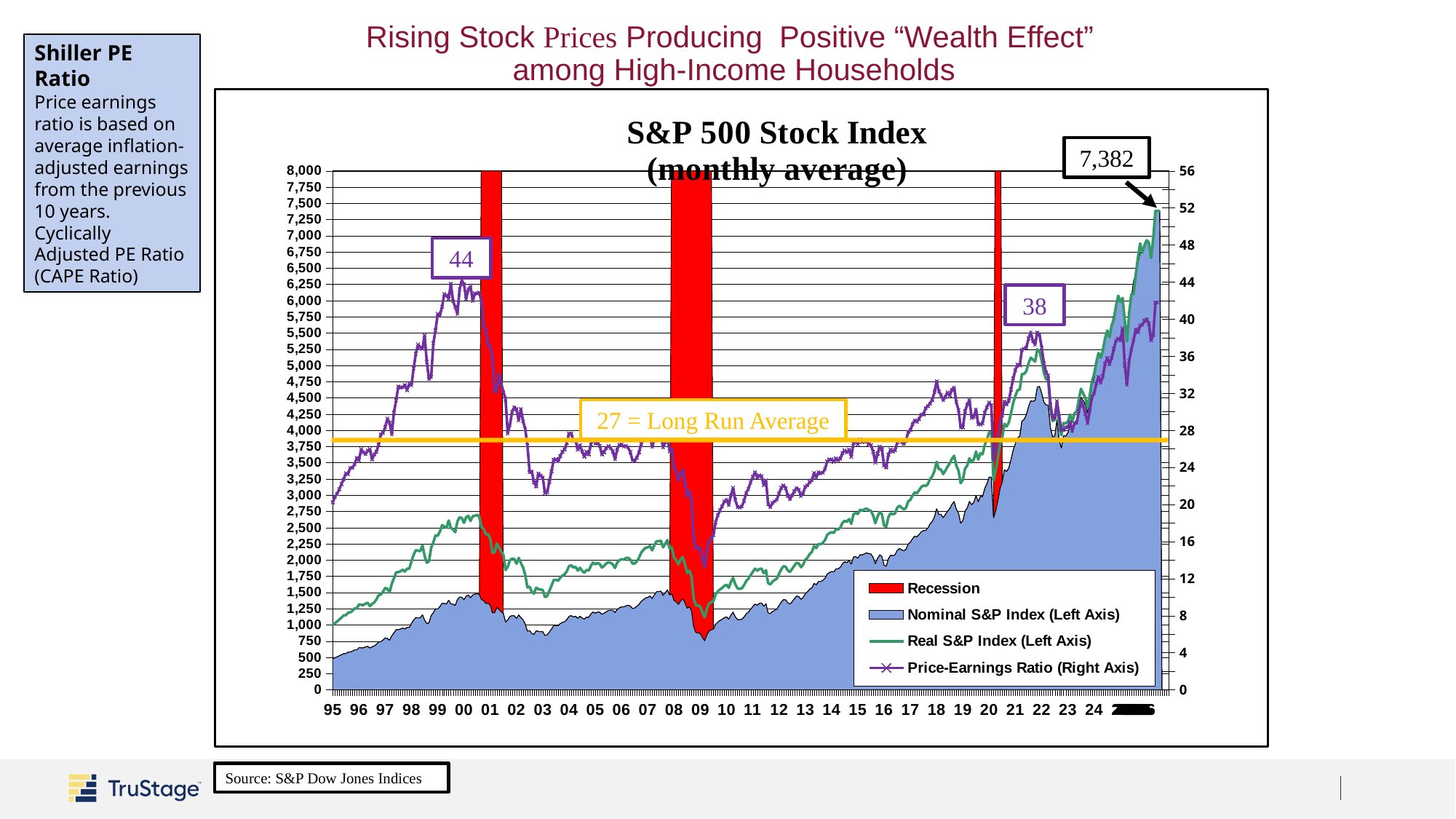
Is the Nominal S&P Index at its 2009 trough greater or less than 1,000? less How many series does the chart legend list? 4 Does the Nominal S&P Index rise or fall from 2020 to 2024? rise What is the difference between the labeled Price-Earnings Ratio peaks of 44 and 38? 6 What is the labeled latest value of the Nominal S&P Index at the right end of the chart? 7,382 What kind of chart is used to plot the Price-Earnings Ratio series? line chart Which labeled Price-Earnings Ratio peak is larger, the one around 2000 or the one around 2021? the one around 2000 (44) How many recession periods are shaded on the chart? 3 What is the labeled peak value of the Price-Earnings Ratio around the year 2000? 44 What is the labeled peak value of the Price-Earnings Ratio around 2021? 38 What value is given as the long run average of the Price-Earnings Ratio? 27 What is the title of the chart? S&P 500 Stock Index (monthly average)